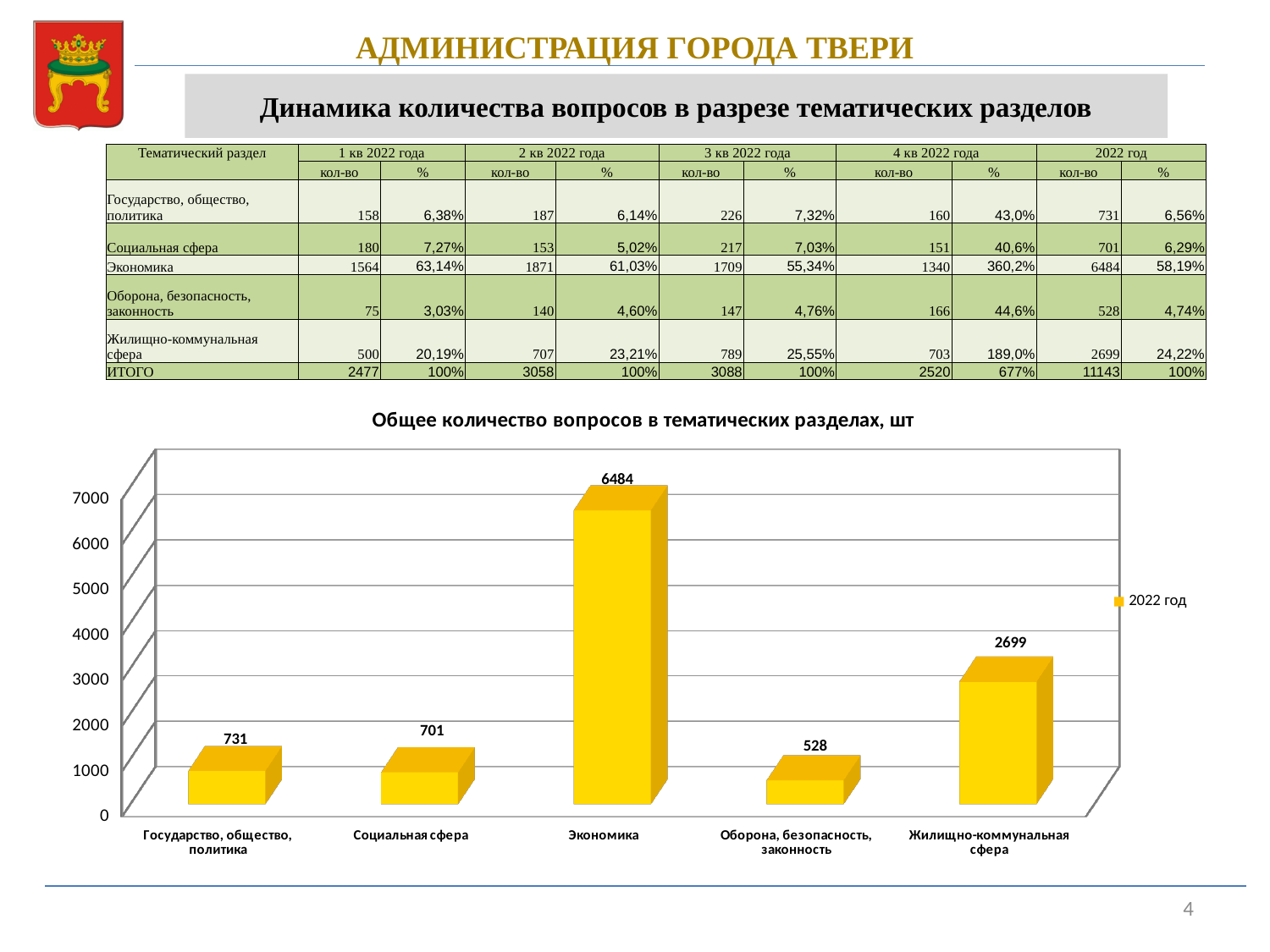
How many categories are shown in the chart? 5 Which category has the lowest value in the chart? Оборона, безопасность, законность What is the value for Жилищно-коммунальная сфера in the chart? 2699 What is the difference between the values for Экономика and Жилищно-коммунальная сфера? 3785 Which category has the highest value in the chart? Экономика What kind of chart is shown on the slide? bar chart What is the value for Экономика in the chart? 6484 What is the value for Оборона, безопасность, законность in the chart? 528 How many series does the chart legend list? 1 What is the difference between the values for Государство, общество, политика and Социальная сфера? 30 Which is larger, the value for Жилищно-коммунальная сфера or the value for Государство, общество, политика? Жилищно-коммунальная сфера What is the title of the chart? Общее количество вопросов в тематических разделах, шт